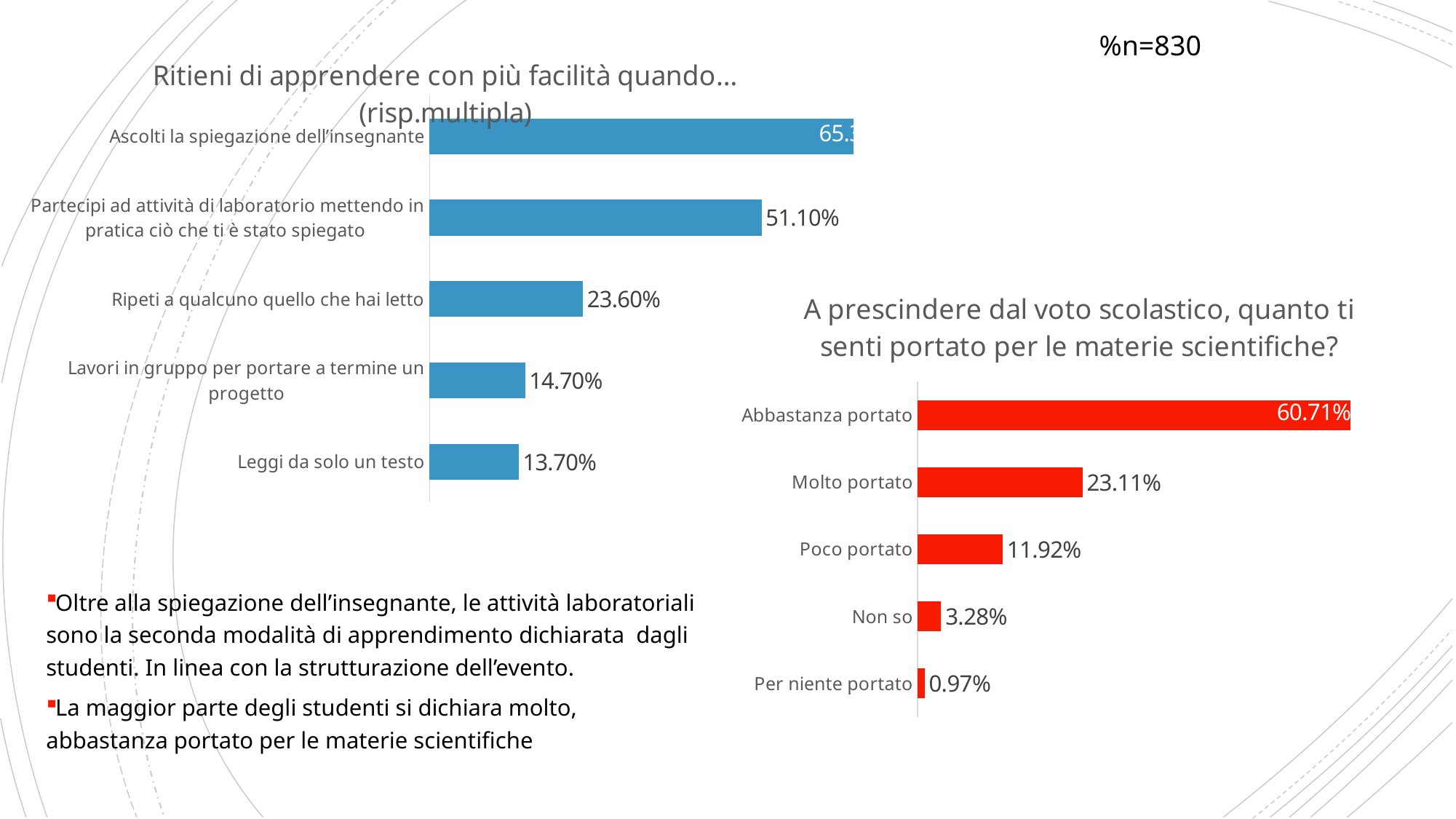
In the chart 'Ritieni di apprendere con più facilità quando…', what is the difference between 'Ripeti a qualcuno quello che hai letto' and 'Lavori in gruppo per portare a termine un progetto'? 8.90% In the chart 'Ritieni di apprendere con più facilità quando…', how many categories are shown? 5 In the chart 'Ritieni di apprendere con più facilità quando…', what is the value for 'Leggi da solo un testo'? 13.70% In the chart 'A prescindere dal voto scolastico, quanto ti senti portato per le materie scientifiche?', what is the value for 'Per niente portato'? 0.97% In the chart 'Ritieni di apprendere con più facilità quando…', what is the value for 'Partecipi ad attività di laboratorio mettendo in pratica ciò che ti è stato spiegato'? 51.10% In the chart 'A prescindere dal voto scolastico, quanto ti senti portato per le materie scientifiche?', which category has the highest value? Abbastanza portato In the chart 'Ritieni di apprendere con più facilità quando…', which category has the lowest value? Leggi da solo un testo In the chart 'A prescindere dal voto scolastico, quanto ti senti portato per le materie scientifiche?', what is the difference between 'Abbastanza portato' and 'Molto portato'? 37.60% What type of chart is the one on the right of the slide? Bar chart In the chart 'A prescindere dal voto scolastico, quanto ti senti portato per le materie scientifiche?', what is the value for 'Molto portato'? 23.11% In the chart 'A prescindere dal voto scolastico, quanto ti senti portato per le materie scientifiche?', which is larger: 'Poco portato' or 'Non so'? Poco portato In the chart 'Ritieni di apprendere con più facilità quando…', which category has the highest value? Ascolti la spiegazione dell'insegnante